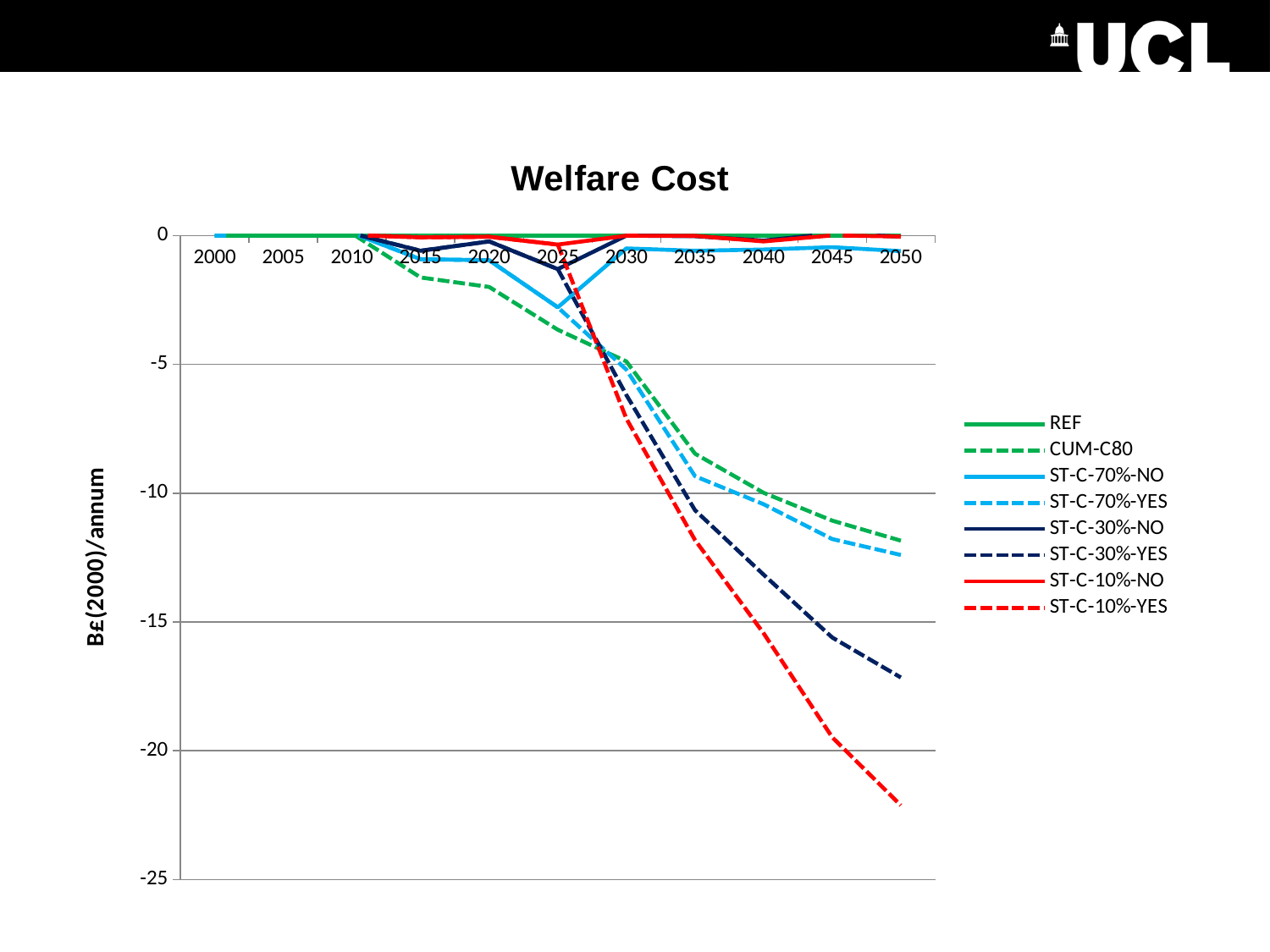
Is the value for CUM-C80 at 2050 greater or less than -10? less What is the label on the vertical axis? B£(2000)/annum Is the value for ST-C-10%-YES at 2050 greater or less than -20? less What is the title of the chart? Welfare Cost Does the ST-C-10%-YES series rise or fall between 2025 and 2050? fall Is the value for ST-C-30%-YES at 2050 greater or less than -15? less How many series does the legend list? 8 Which series reaches the lowest value at 2050? ST-C-10%-YES What kind of chart is shown on the slide? line chart How many year labels are shown along the x axis? 11 At 2050, which series has the lower value, ST-C-10%-YES or ST-C-30%-YES? ST-C-10%-YES